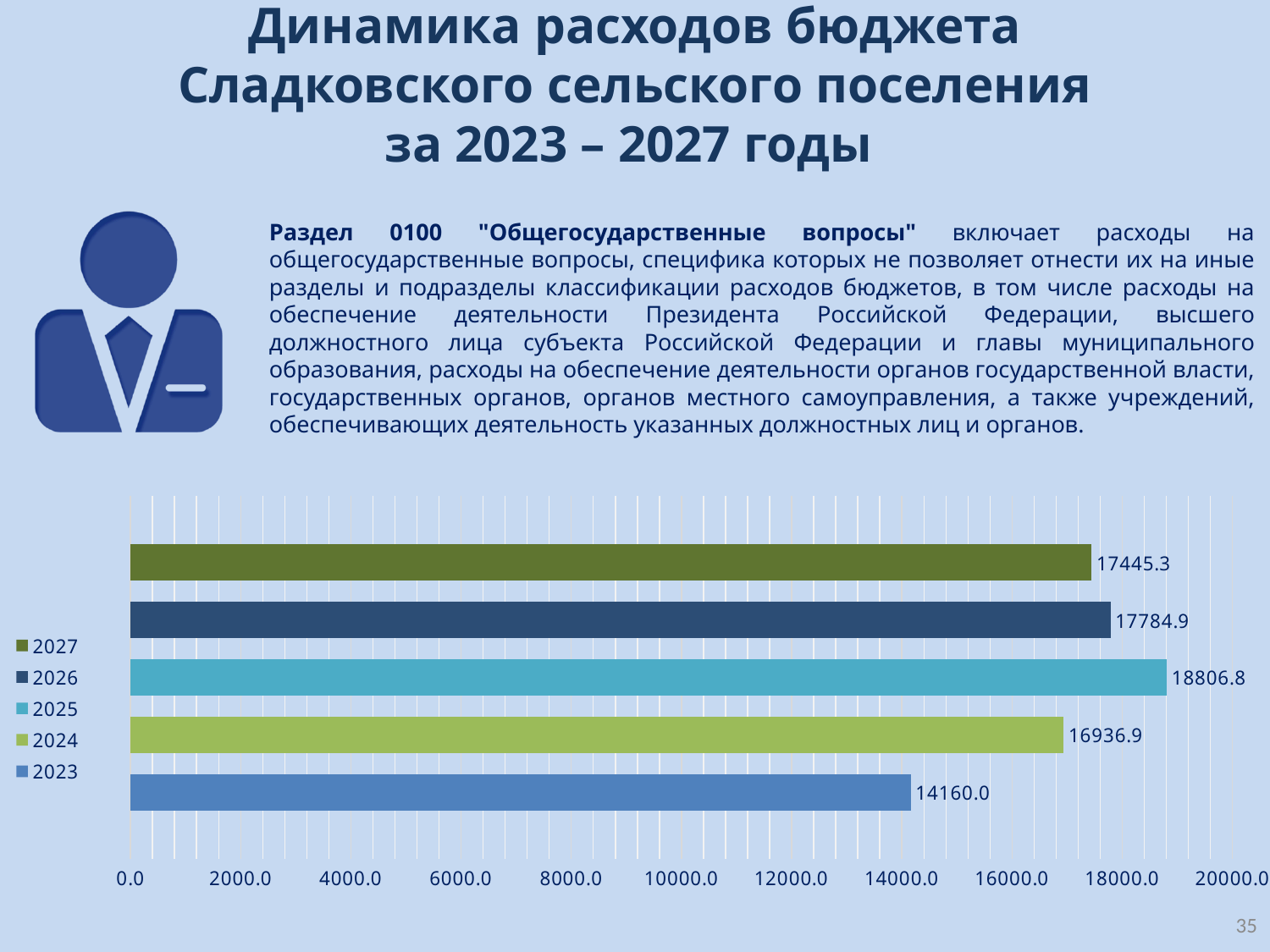
Do the values rise or fall from 2023 to 2025? rise Which year has the lowest value? 2023 How many series does the legend list? 5 Which year has the highest value? 2025 What is the value for 2025? 18806.8 Which is larger, the value for 2024 or the value for 2026? 2026 What is the value for 2027? 17445.3 What kind of chart is shown on the slide? bar chart What is the value for 2023? 14160.0 Is the value for 2024 greater or less than 16000.0? greater What is the difference between the values for 2026 and 2027? 339.6 What is the difference between the values for 2025 and 2023? 4646.8